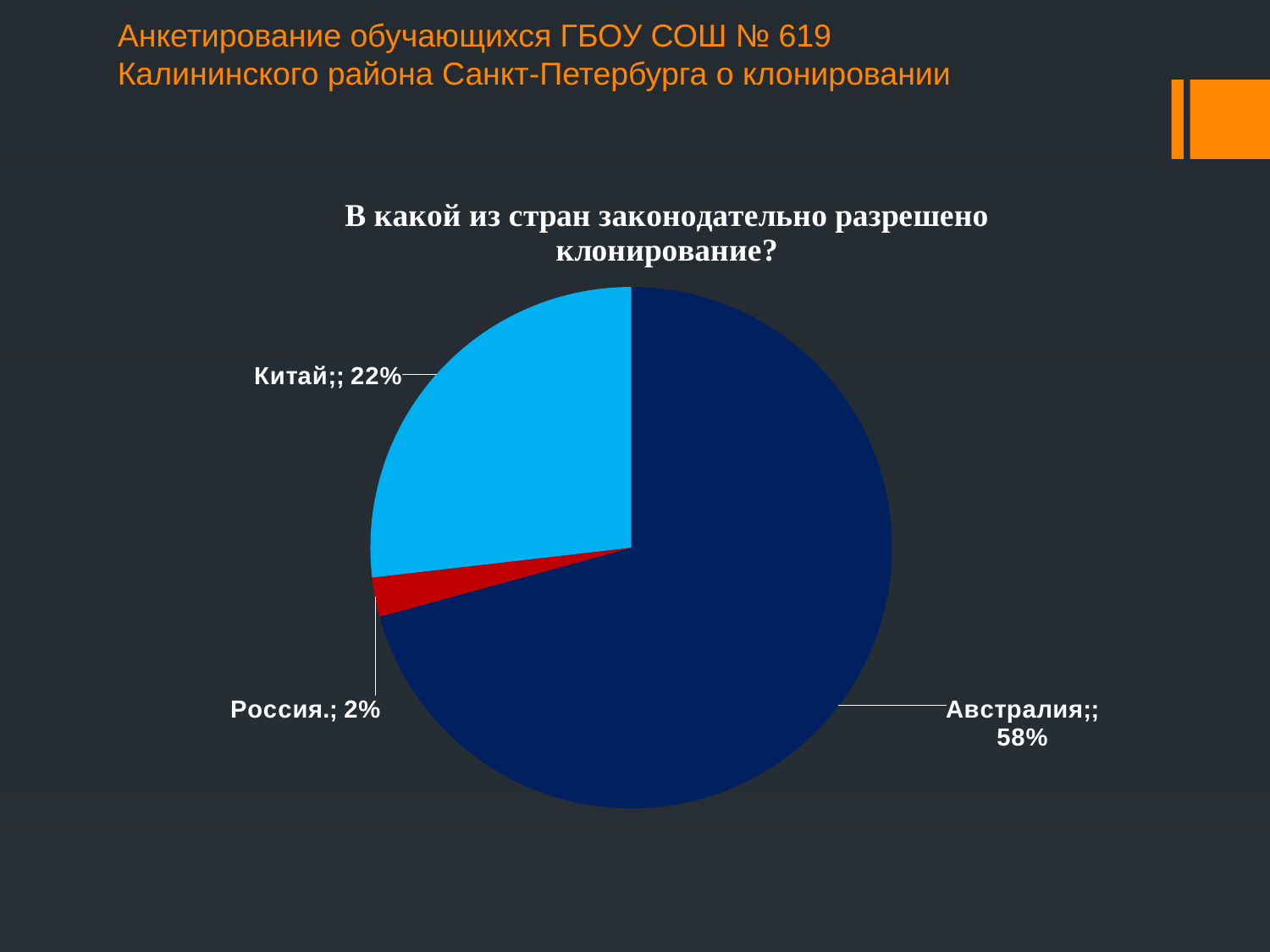
Which slice is larger, Китай or Россия? Китай Which country has the largest slice in the pie chart? Австралия What type of chart is shown on the slide? Pie chart Which country has the smallest slice in the pie chart? Россия What percentage is shown for Россия in the pie chart? 2% What percentage is shown for Китай in the pie chart? 22% What colour is the slice for Россия? Red What is the title of the chart? В какой из стран законодательно разрешено клонирование? How many slices does the pie chart have? 3 What is the difference between the percentages shown for Австралия and Китай? 36% What percentage is shown for Австралия in the pie chart? 58% What is the difference between the percentages shown for Китай and Россия? 20%